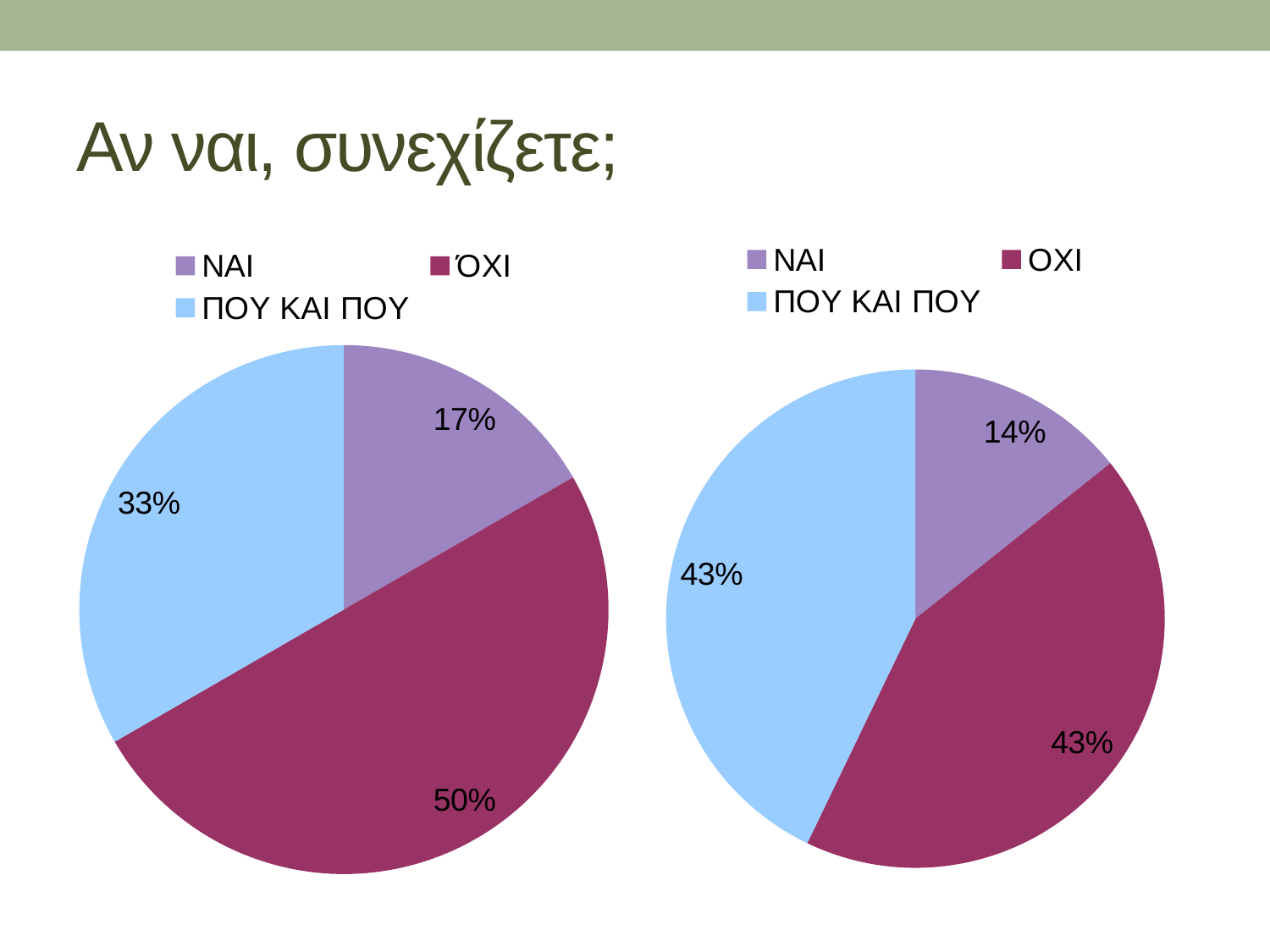
In the left pie chart, which is larger, the ΠΟΥ ΚΑΙ ΠΟΥ slice or the ΝΑΙ slice? ΠΟΥ ΚΑΙ ΠΟΥ How many slices does the right pie chart have? 3 In the left pie chart, what share is labelled for ΝΑΙ? 17% In the right pie chart, which category has the smallest slice? ΝΑΙ In the left pie chart, which category has the largest slice? ΌΧΙ In the right pie chart, what share is labelled for ΝΑΙ? 14% What type of chart is shown on the left of the slide? Pie chart In the left pie chart, what share is labelled for ΌΧΙ? 50% In the right pie chart, what share is labelled for ΠΟΥ ΚΑΙ ΠΟΥ? 43% In the left pie chart, what is the difference between the ΌΧΙ share and the ΝΑΙ share? 33% In the right pie chart, what is the difference between the ΟΧΙ share and the ΝΑΙ share? 29% In the left pie chart, what share is labelled for ΠΟΥ ΚΑΙ ΠΟΥ? 33%